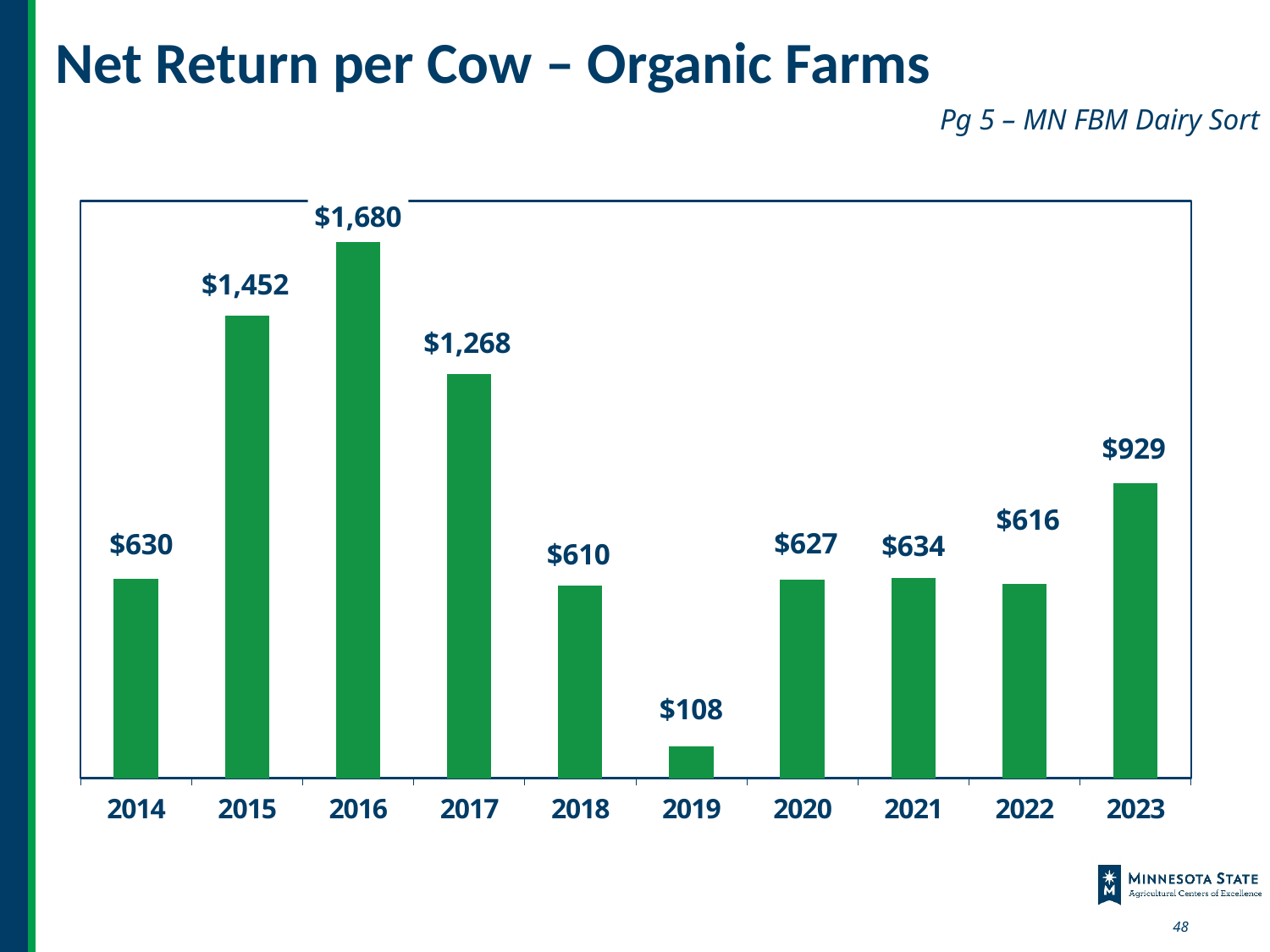
Which year has the highest net return per cow? 2016 Which year has the lowest net return per cow? 2019 What is the difference between the net return per cow in 2016 and in 2015? $228 Does the net return per cow rise or fall from 2016 to 2019? Fall Which year has a larger net return per cow, 2014 or 2019? 2014 Which year has a larger net return per cow, 2017 or 2023? 2017 What kind of chart is shown on the slide? Bar chart What is the difference between the net return per cow in 2023 and in 2022? $313 What is the net return per cow for organic farms in 2019? $108 What is the net return per cow for organic farms in 2023? $929 How many years are shown on the chart? 10 What is the net return per cow for organic farms in 2016? $1,680